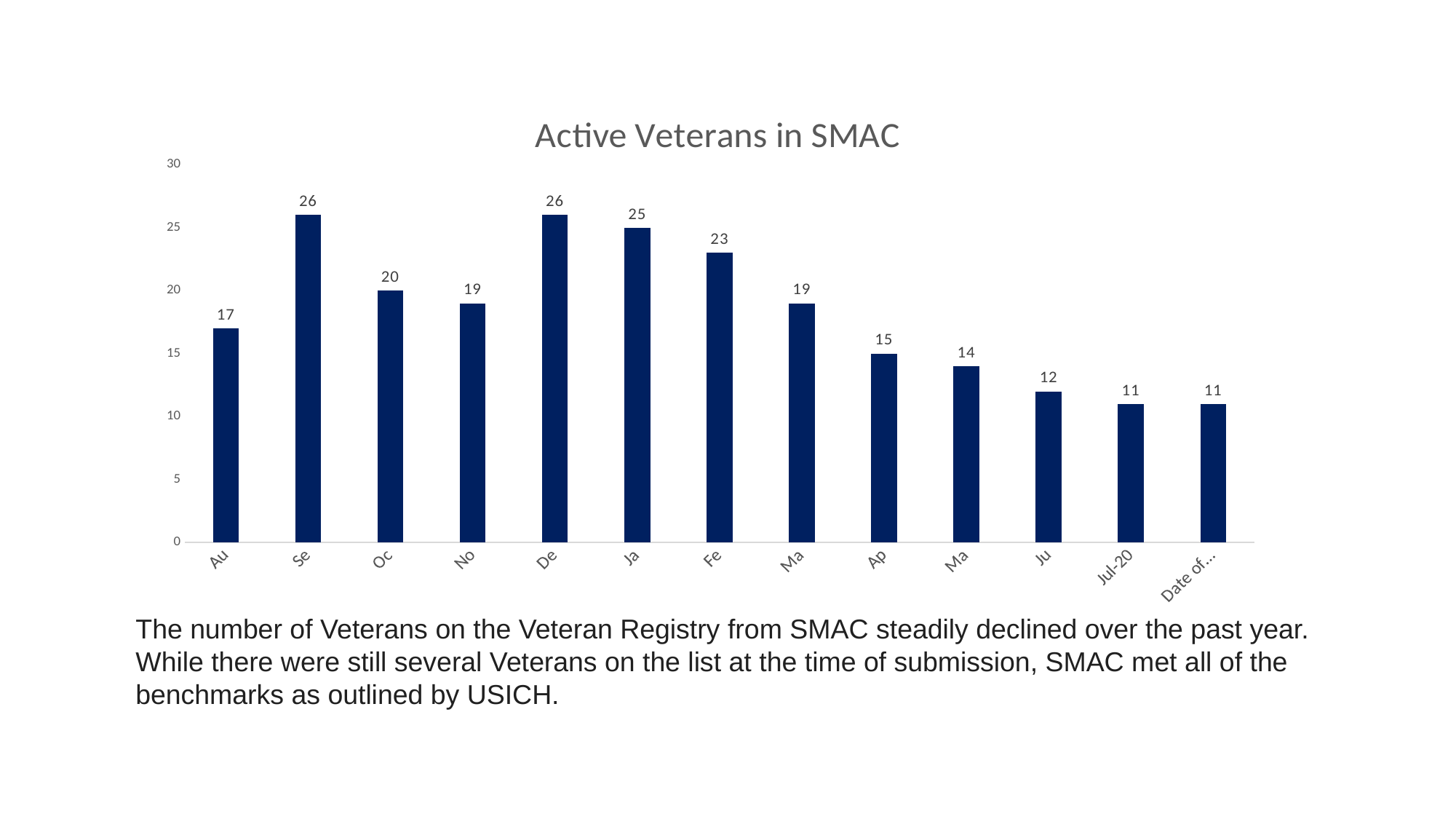
What is the difference between the values for Se and Ap? 11 What is the value for Au? 17 How many bars are plotted in the chart? 13 What is the value for Fe? 23 What is the highest value shown in the chart? 26 What is the value for Jul-20? 11 Which is larger, the value for Ja or the value for Oc? Ja What is the value for Se? 26 From Ja onward, do the values rise or fall along the x axis? Fall What kind of chart is shown on the slide? Bar chart What is the title of the chart? Active Veterans in SMAC What is the lowest value shown in the chart? 11